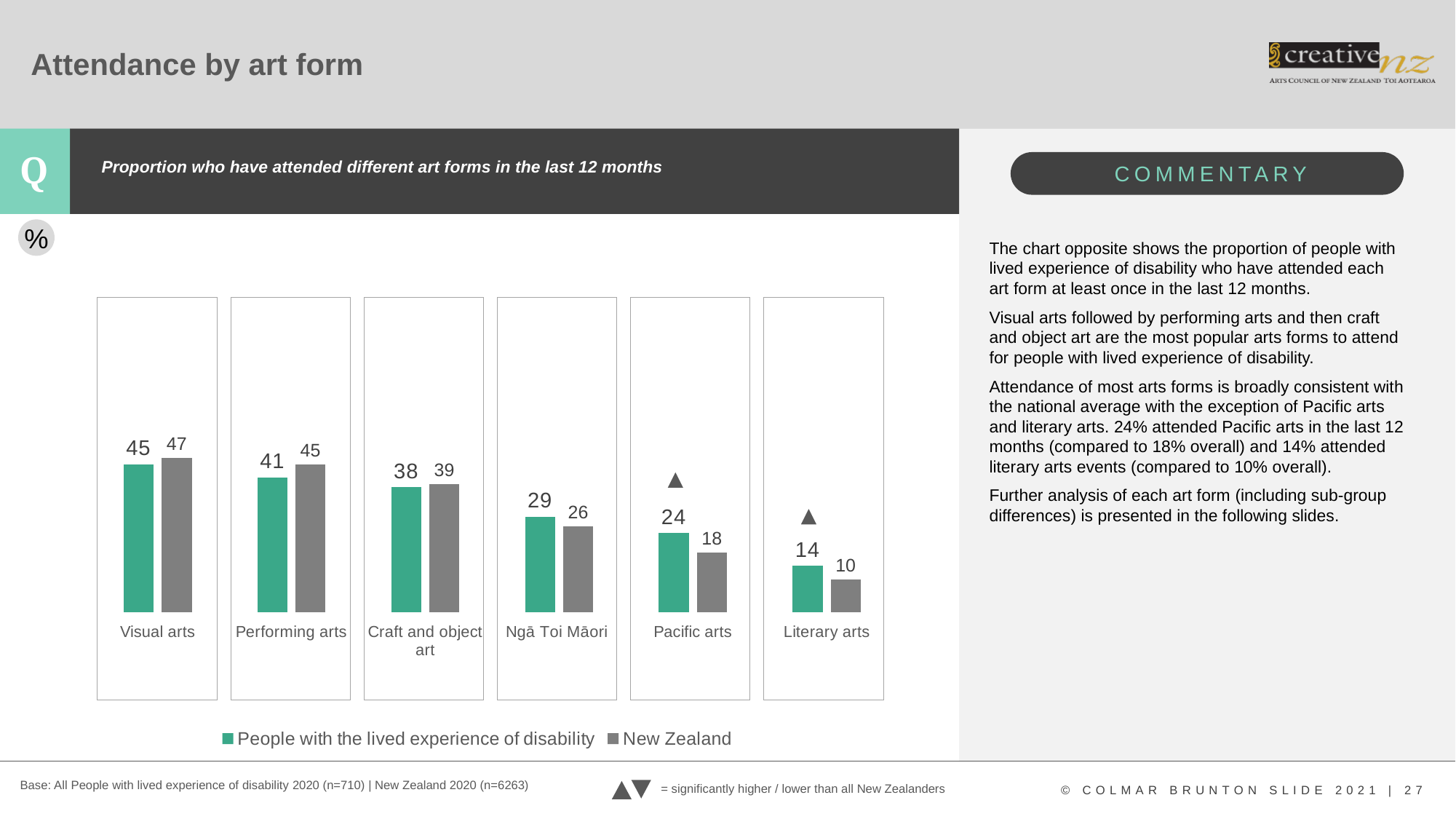
Which art form has the lowest New Zealand value? Literary arts What colour are the bars for the New Zealand series? Grey How many art forms are shown in the chart? 6 What kind of chart is shown on the slide? Bar chart What is the New Zealand value for Pacific arts? 18 How many series does the legend list? 2 What is the value for People with the lived experience of disability for Visual arts? 45 What is the value for People with the lived experience of disability for Literary arts? 14 For Ngā Toi Māori, which is larger: the value for People with the lived experience of disability or the New Zealand value? People with the lived experience of disability Do the values for People with the lived experience of disability rise or fall from Visual arts to Literary arts? Fall What is the difference between the People with the lived experience of disability value and the New Zealand value for Pacific arts? 6 Which art form has the highest value for People with the lived experience of disability? Visual arts